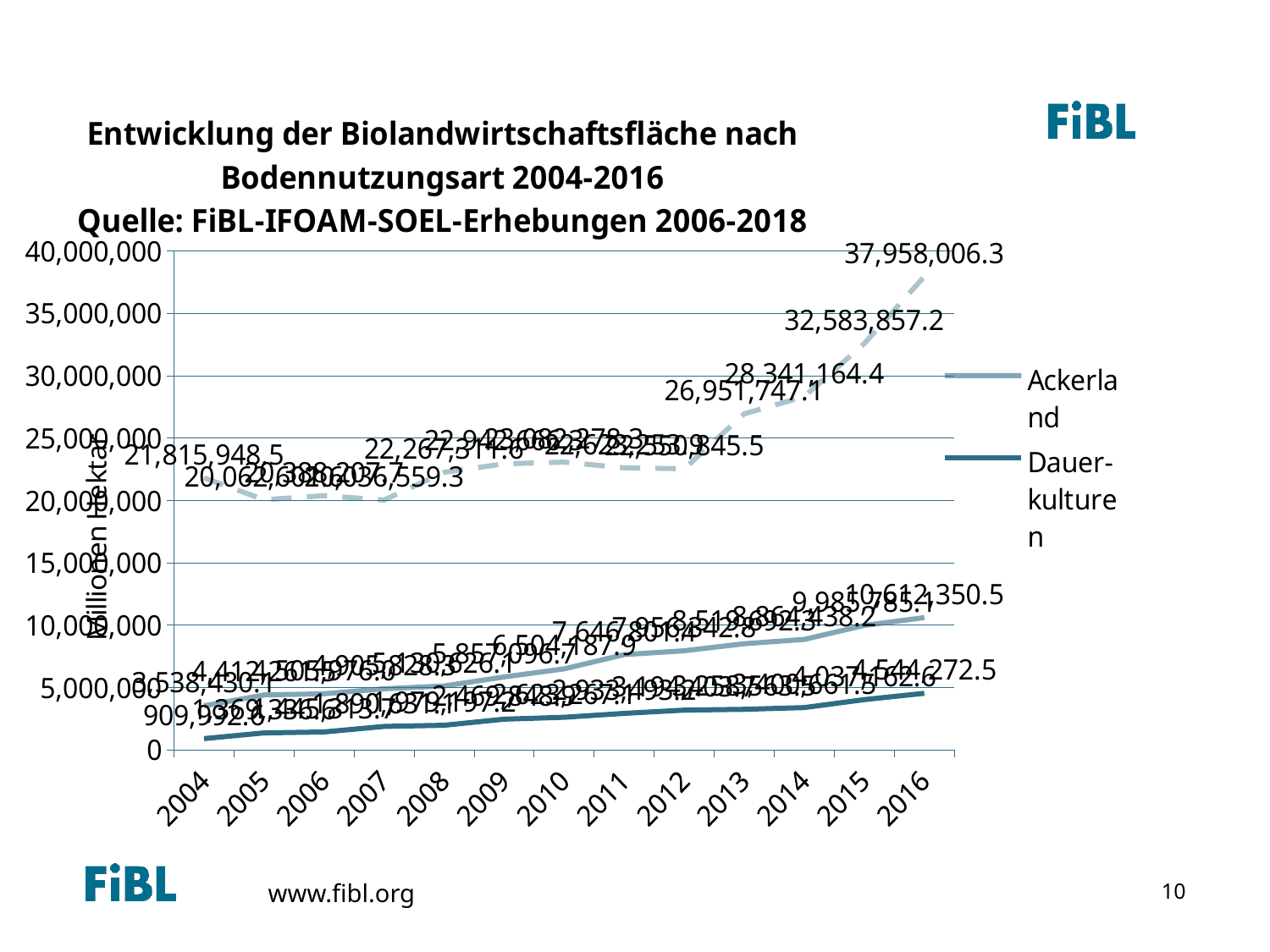
What kind of chart is shown on the slide? line chart Does the Ackerland line rise or fall from 2004 to 2016? rise How many years are shown on the x axis of the chart? 13 Is the value for Dauerkulturen in 2016 greater or less than 5,000,000? less What is the value of the top dashed line in 2015? 32,583,857.2 What is the value for Dauerkulturen in 2016? 4,544,272.5 How many entries does the chart legend list? 2 What is the value of the top dashed line in 2016? 37,958,006.3 What is the difference between Ackerland and Dauerkulturen in 2016? 6,068,078.0 What is the value of the top dashed line in 2014? 28,341,164.4 In 2016, which is larger: Ackerland or Dauerkulturen? Ackerland What is the value for Ackerland in 2016? 10,612,350.5